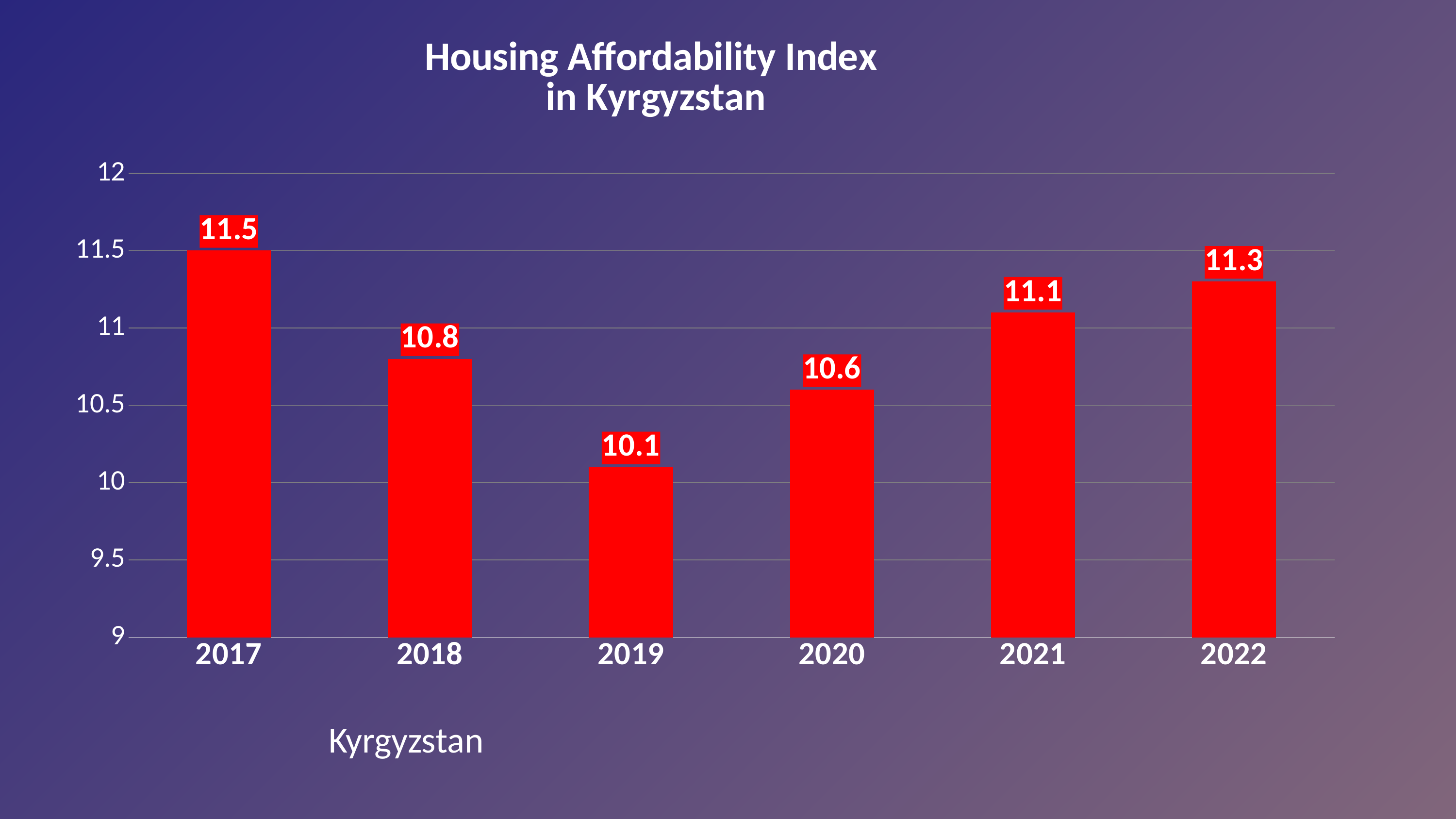
What is the Housing Affordability Index value for 2022? 11.3 How many years are shown on the chart? 6 Which year has the highest Housing Affordability Index value? 2017 Which year has the lowest Housing Affordability Index value? 2019 What is the difference between the 2017 value and the 2019 value? 1.4 Do the values rise or fall from 2019 to 2022? rise What kind of chart is shown on the slide? bar chart Which is larger, the value for 2018 or the value for 2020? 2018 What is the Housing Affordability Index value for 2017? 11.5 What is the difference between the 2022 value and the 2021 value? 0.2 Is the value for 2020 greater or less than 11? less What is the Housing Affordability Index value for 2019? 10.1